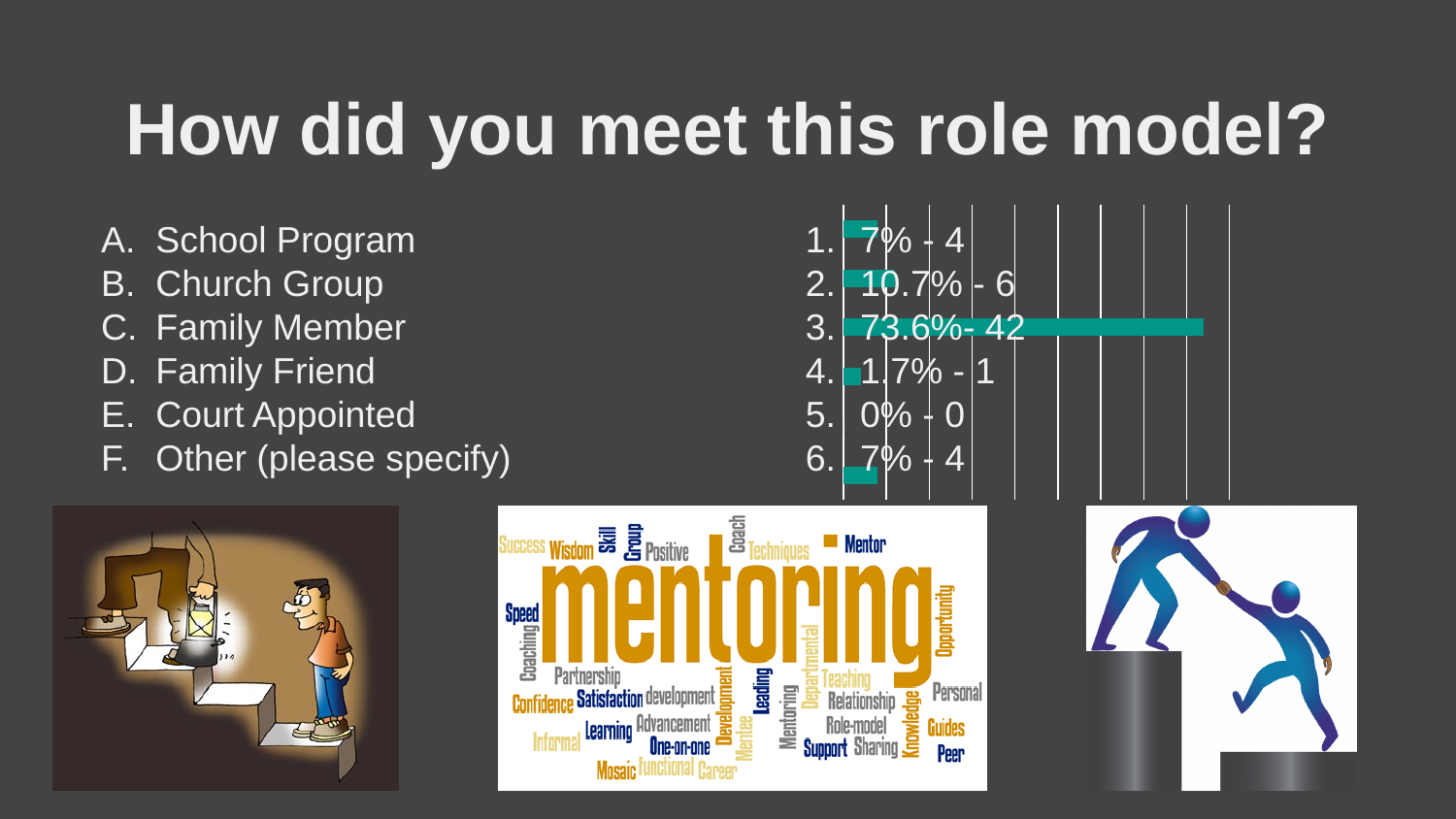
Which response option has the lowest value in the chart? Court Appointed (option 5) What kind of chart is shown on the slide? bar chart What percentage of respondents chose option 3, Family Member? 73.6% Which is larger, the value for Church Group (option 2) or School Program (option 1)? Church Group How many bars (response options) does the chart show? 6 What is the total number of respondents across all six options in the chart? 57 How many respondents chose option 2, Church Group? 6 Which response option has the highest value in the chart? Family Member (option 3) How many respondents chose option 6, Other (please specify)? 4 What percentage is shown for option 4, Family Friend? 1.7% How many more respondents chose Family Member (option 3) than Church Group (option 2)? 36 What is the title of the slide containing the chart? How did you meet this role model?